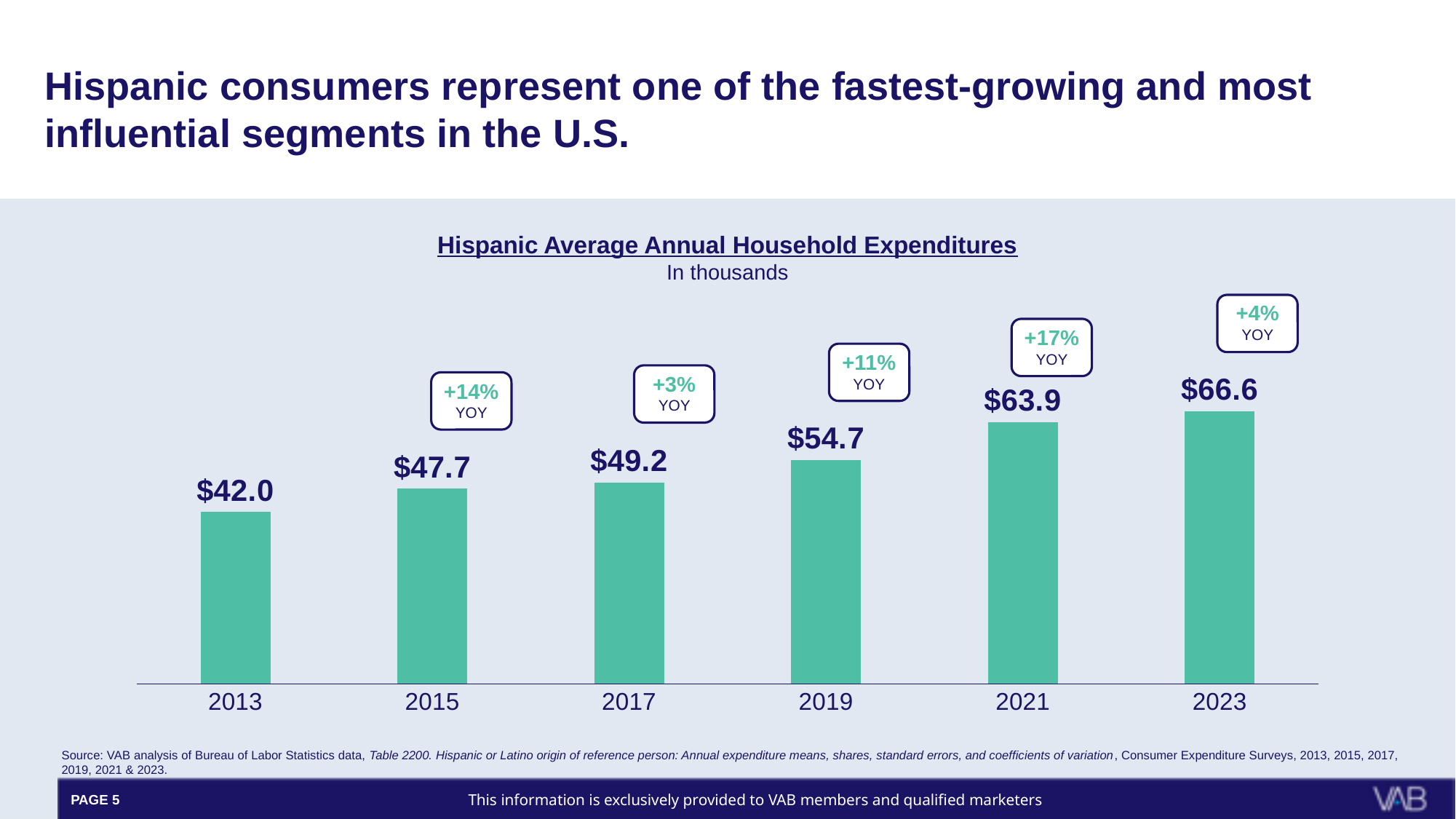
What value is shown for 2023? $66.6 What kind of chart is shown on the slide? Bar chart Which year has the highest average annual household expenditure? 2023 What year-over-year percentage change is labeled above the 2021 bar? +17% What is the difference between the values for 2021 and 2019? $9.2 How many years are shown on the x axis? 6 What value is shown for 2019? $54.7 What is the Hispanic average annual household expenditure shown for 2013? $42.0 Which year has the lowest average annual household expenditure? 2013 Which is larger, the value for 2017 or the value for 2015? 2017 What is the difference between the values for 2023 and 2013? $24.6 Do the values rise or fall from 2013 to 2023? Rise